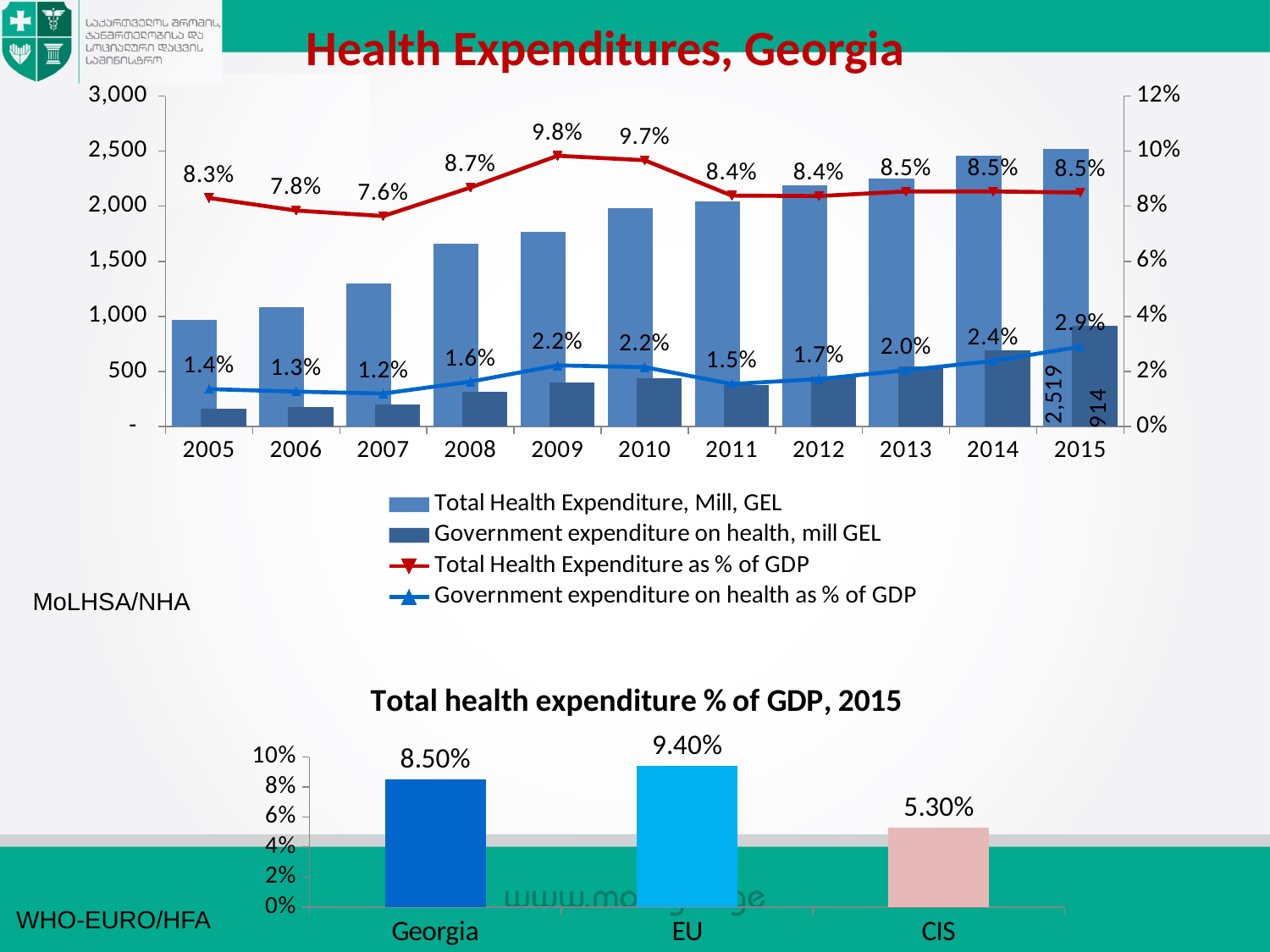
In the 'Health Expenditures, Georgia' chart, how many series does the legend list? 4 In the 'Health Expenditures, Georgia' chart, how many years are shown on the x axis? 11 In the 'Total health expenditure % of GDP, 2015' chart, what is the difference between the EU and Georgia values? 0.90% In the 'Total health expenditure % of GDP, 2015' chart, what is the value for EU? 9.40% In the 'Health Expenditures, Georgia' chart, is the Total Health Expenditure, Mill, GEL bar for 2008 greater or less than 1,500? greater In the 'Health Expenditures, Georgia' chart, which year has the highest Government expenditure on health as % of GDP? 2015 In the 'Health Expenditures, Georgia' chart, what was Total Health Expenditure as % of GDP in 2009? 9.8% In the 'Total health expenditure % of GDP, 2015' chart, which category has the lowest value? CIS In the 'Health Expenditures, Georgia' chart, what is the difference between Total Health Expenditure as % of GDP in 2009 and in 2007? 2.2% In the 'Health Expenditures, Georgia' chart, what is the labelled value of Total Health Expenditure, Mill, GEL in 2015? 2,519 In the 'Health Expenditures, Georgia' chart, what was Government expenditure on health as % of GDP in 2015? 2.9% In the 'Health Expenditures, Georgia' chart, which year has the lowest Total Health Expenditure as % of GDP? 2007